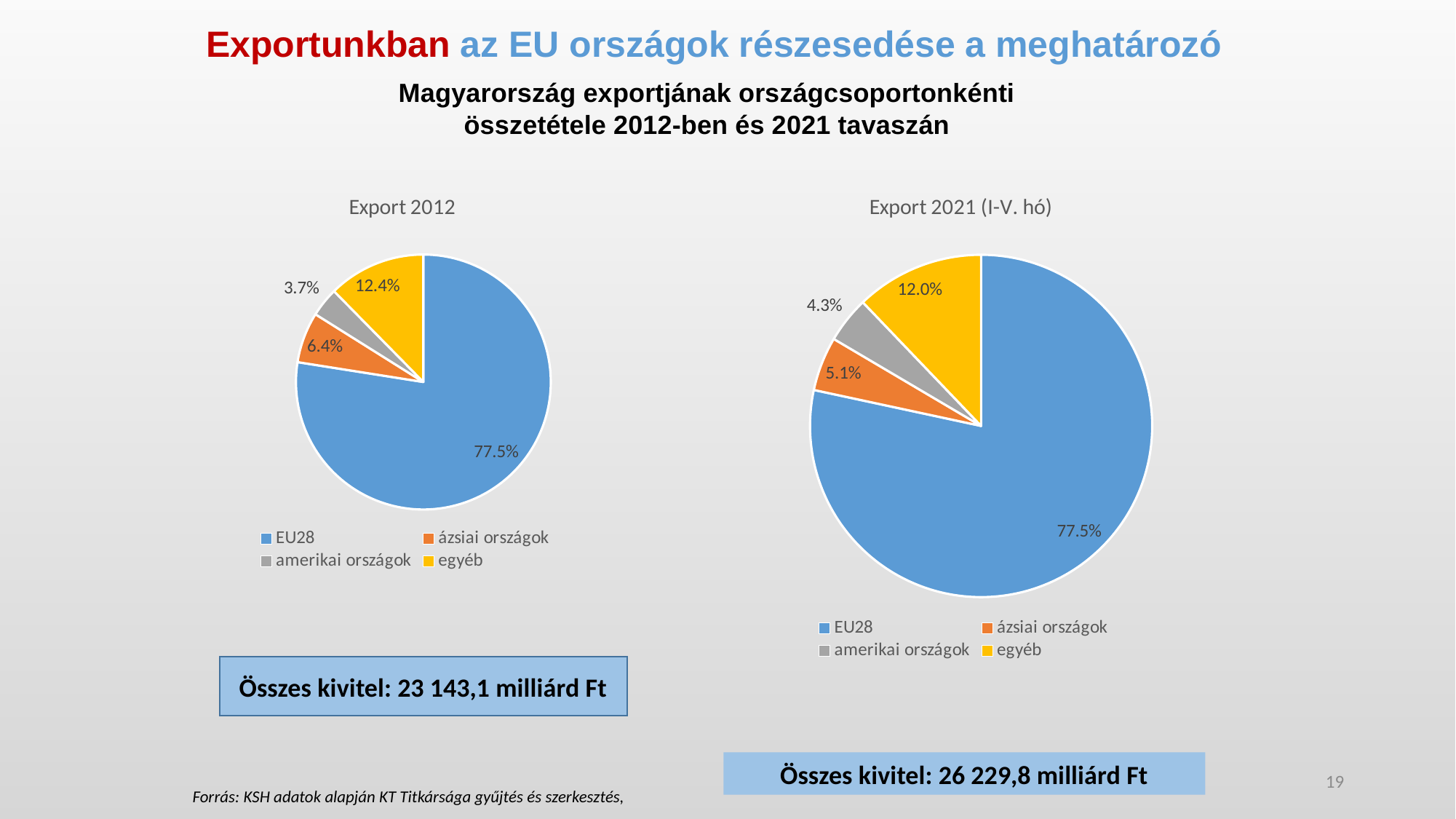
In the "Export 2012" chart, which category has the smallest share? amerikai országok How many entries does the legend of the "Export 2012" chart list? 4 In the "Export 2021 (I-V. hó)" chart, what is the share of amerikai országok? 4.3% In the "Export 2012" chart, what share does EU28 have? 77.5% In the "Export 2012" chart, what is the share of ázsiai országok? 6.4% In the "Export 2021 (I-V. hó)" chart, which category has the largest share? EU28 In the "Export 2021 (I-V. hó)" chart, which is larger: the share of ázsiai országok or amerikai országok? ázsiai országok In the "Export 2021 (I-V. hó)" chart, what is the share of egyéb? 12.0% In the "Export 2012" chart, what is the difference between the egyéb share and the ázsiai országok share? 6.0% How many slices does the "Export 2012" pie chart have? 4 In the "Export 2021 (I-V. hó)" chart, which colour represents egyéb? Yellow What type of chart is "Export 2021 (I-V. hó)"? Pie chart